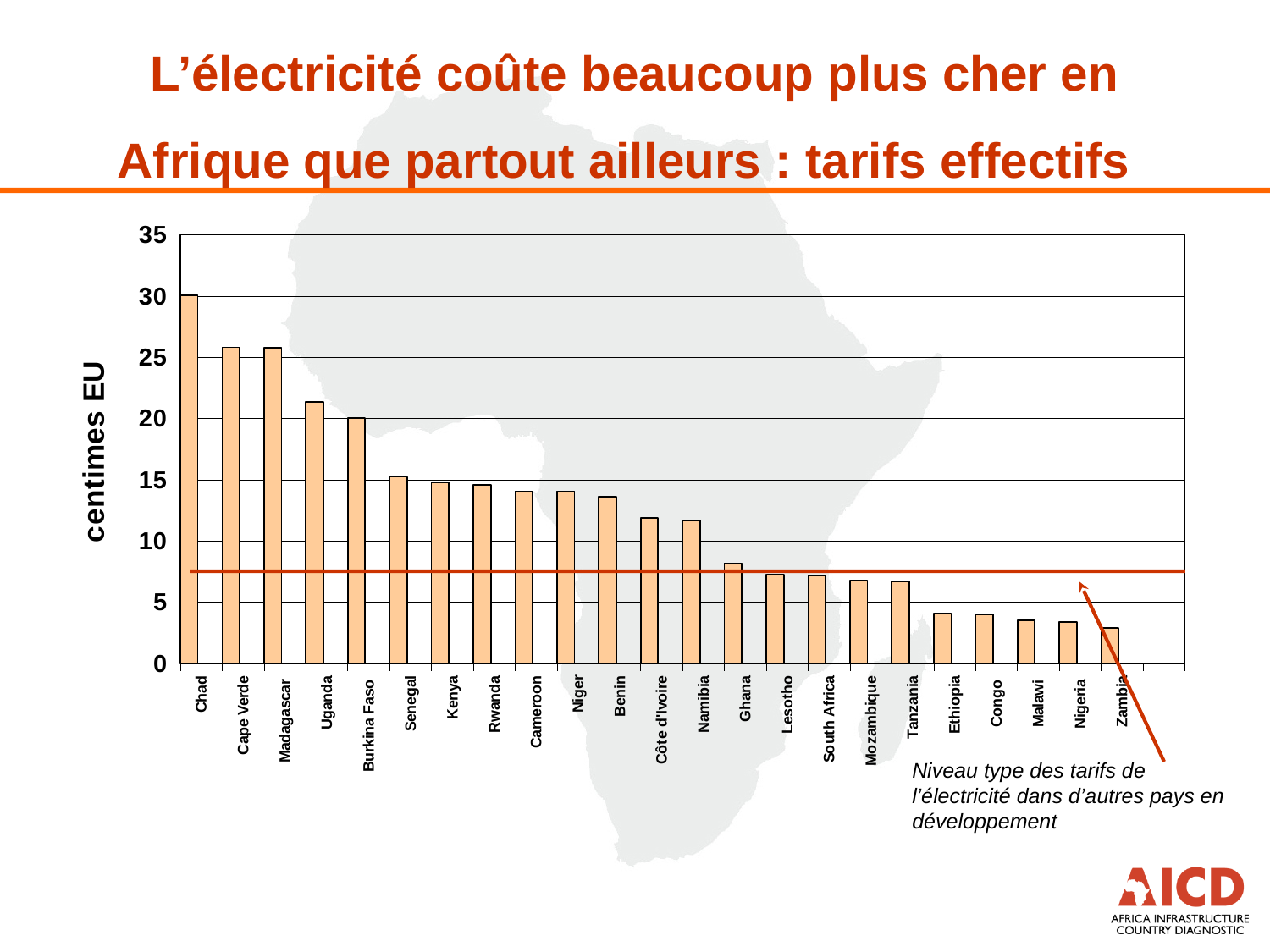
What is the label on the y axis of the chart? centimes EU Is the value for Chad greater or less than 25? greater Which country has the lowest electricity tariff in the chart? Zambia Which has the higher value, Chad or Cape Verde? Chad Is the value for Ethiopia greater or less than 5? less Do the values rise or fall moving from left to right along the x axis? fall Is the value for Namibia greater or less than 10? greater Which country has the highest electricity tariff in the chart? Chad What kind of chart is shown on the slide? bar chart How many countries are shown on the x axis of the chart? 23